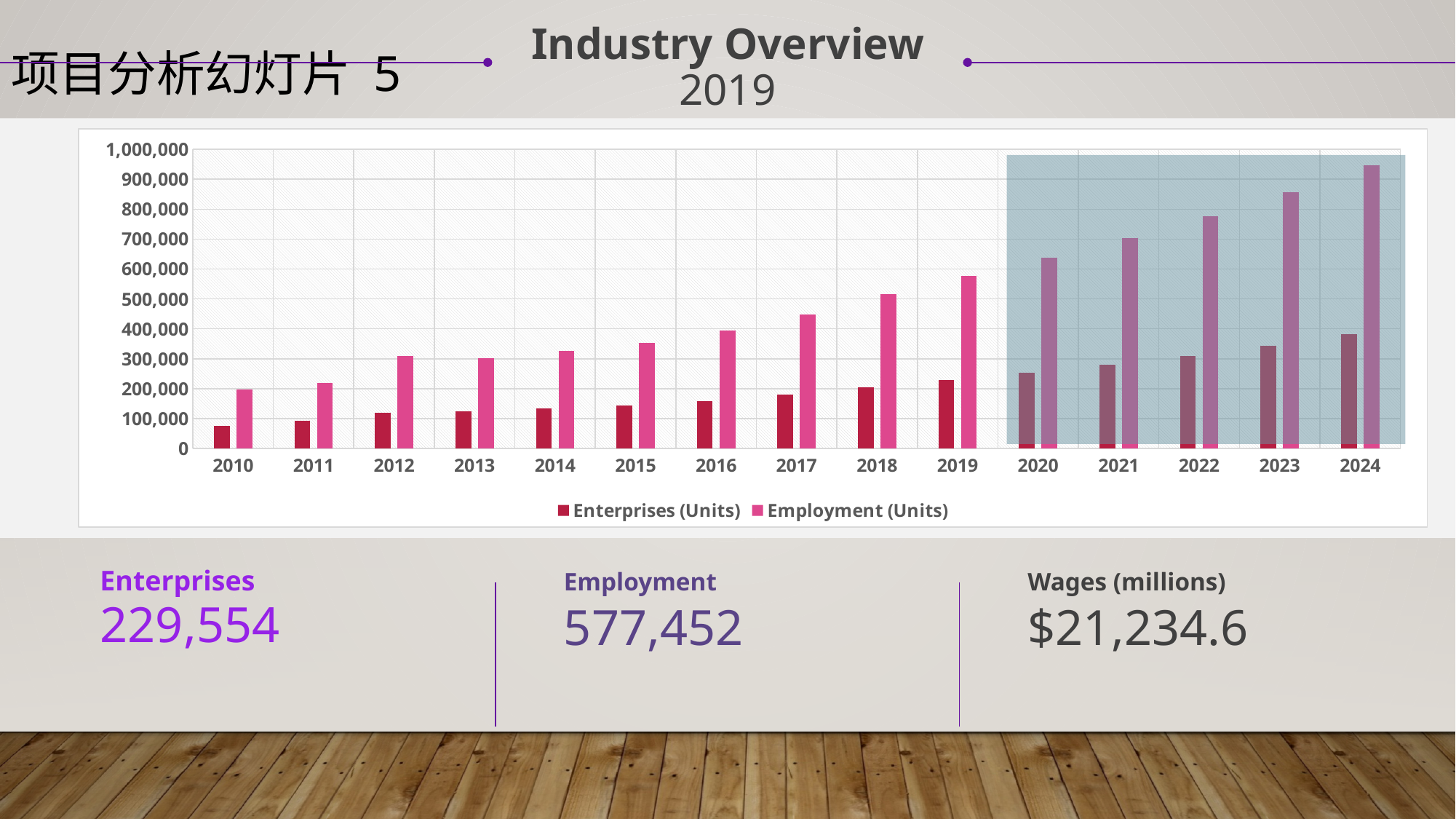
Is the Employment (Units) value for 2020 greater or less than 600,000? greater What kind of chart is shown on the slide? bar chart Which year has the highest Employment (Units) value? 2024 Is the Enterprises (Units) value for 2010 greater or less than 100,000? less How many years are shown on the x axis of the chart? 15 In 2019, which is larger: Enterprises (Units) or Employment (Units)? Employment (Units) Which year has the lowest Enterprises (Units) value? 2010 Do the Employment (Units) values rise or fall from 2010 to 2024? rise Is the Employment (Units) value for 2024 greater or less than 900,000? greater What are the two series named in the chart legend? Enterprises (Units) and Employment (Units) How many series does the chart legend list? 2